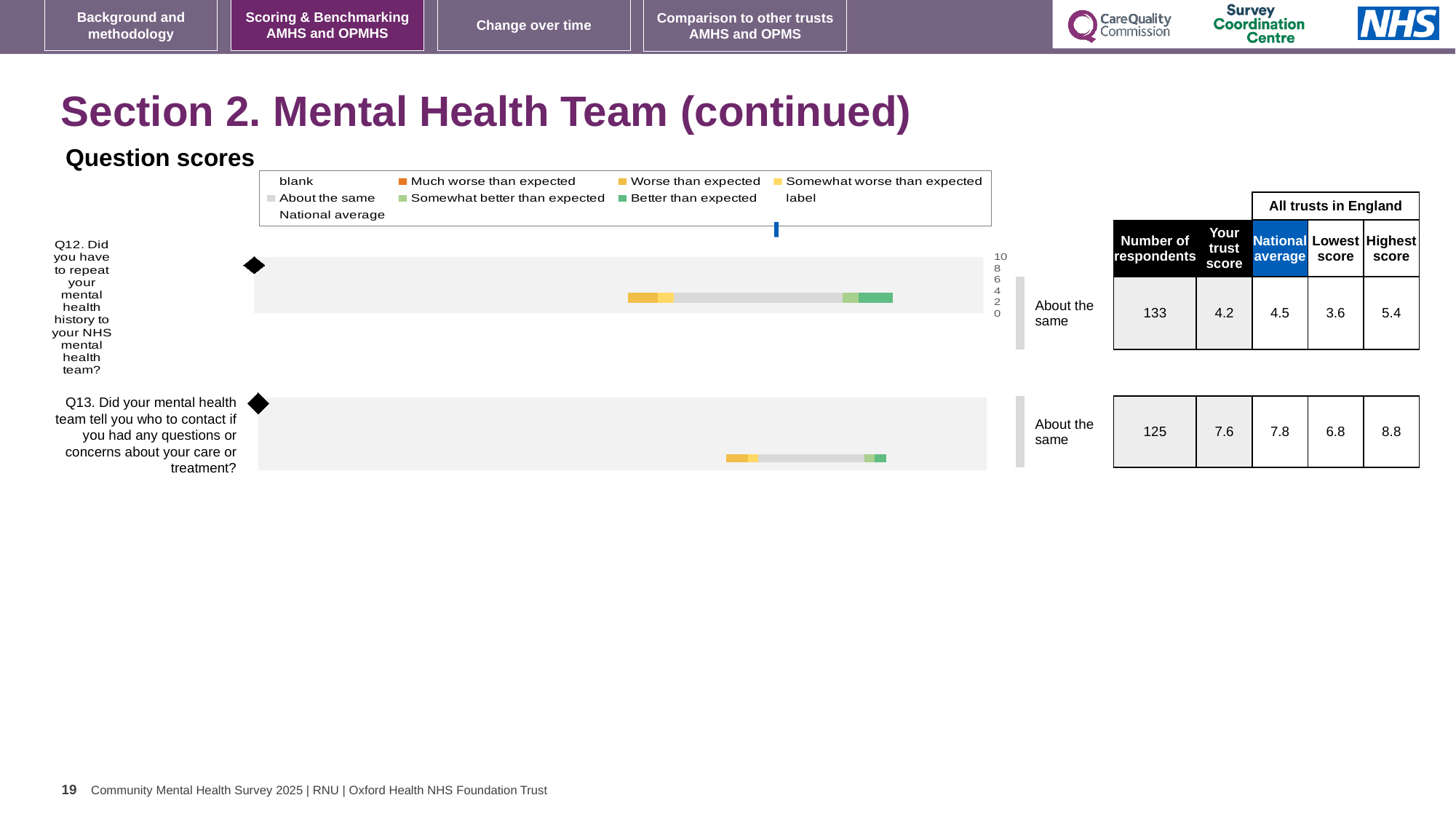
For Q12, which is larger: the trust's score or the national average? National average By how much does the national average exceed the trust's score for Q12? 0.3 What is the highest score among all trusts in England for Q13? 8.8 Which question had more respondents, Q12 or Q13? Q12 How many questions are plotted on this slide? 2 What is the lowest score among all trusts in England for Q12? 3.6 What benchmark category is shown for Q13's result? About the same What is the trust's score for Q12 (repeating your mental health history)? 4.2 What is the national average score for Q13 (being told who to contact)? 7.8 What is the difference between the highest and lowest scores for Q13? 2.0 What kind of chart is used to show the question scores? Bar chart How many respondents are shown for Q12 (repeating your mental health history)? 133